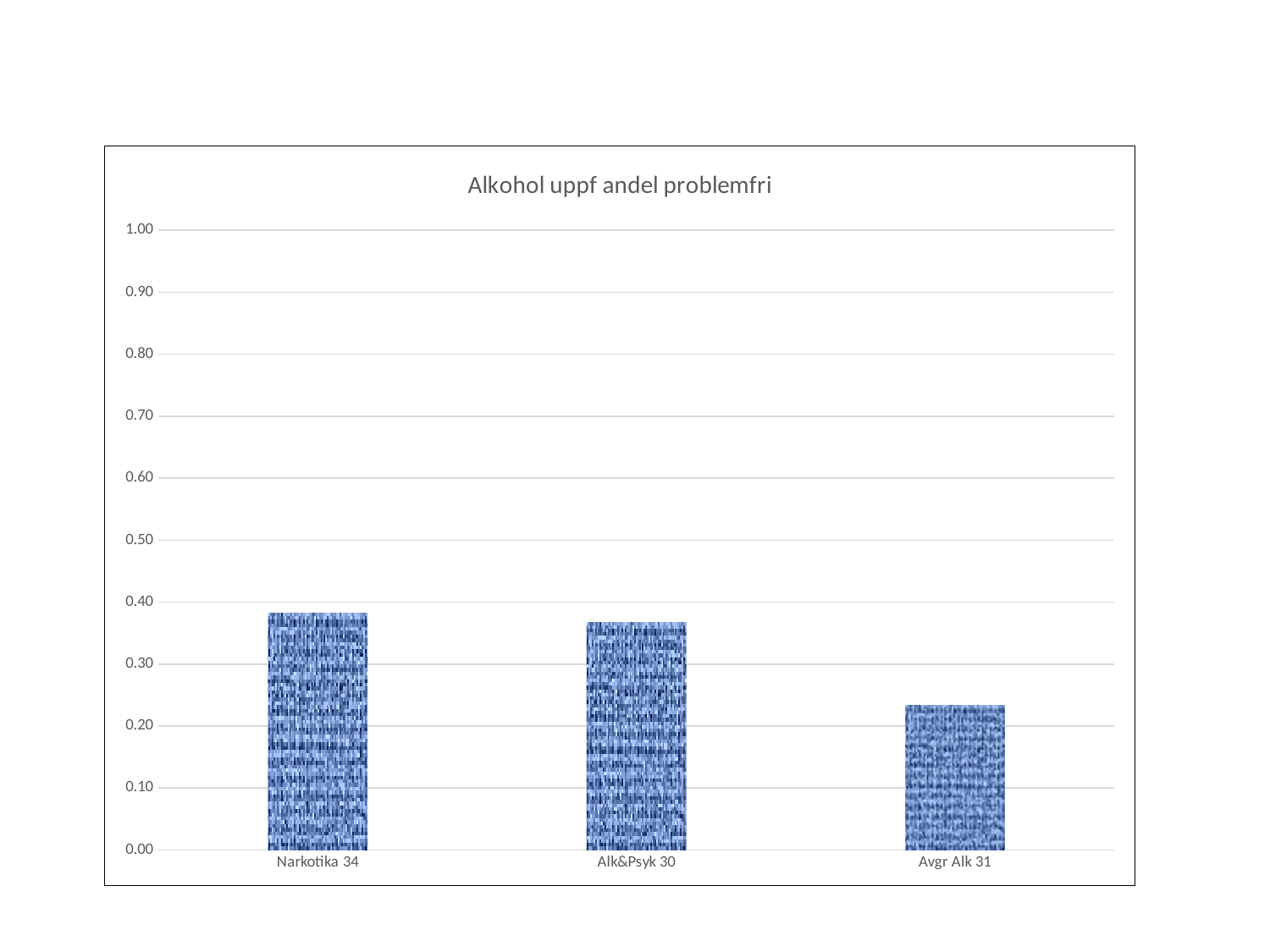
Is the value for Alk&Psyk 30 greater or less than 0.30? greater Is the value for Narkotika 34 greater or less than 0.40? less What kind of chart is shown on the slide? bar chart Which category has the lowest value? Avgr Alk 31 Is the value for Avgr Alk 31 greater or less than 0.20? greater Which is larger, the value for Narkotika 34 or the value for Avgr Alk 31? Narkotika 34 Which is larger, the value for Alk&Psyk 30 or the value for Avgr Alk 31? Alk&Psyk 30 How many categories are plotted in the chart? 3 What is the title of the chart? Alkohol uppf andel problemfri What is the highest value shown on the vertical axis? 1.00